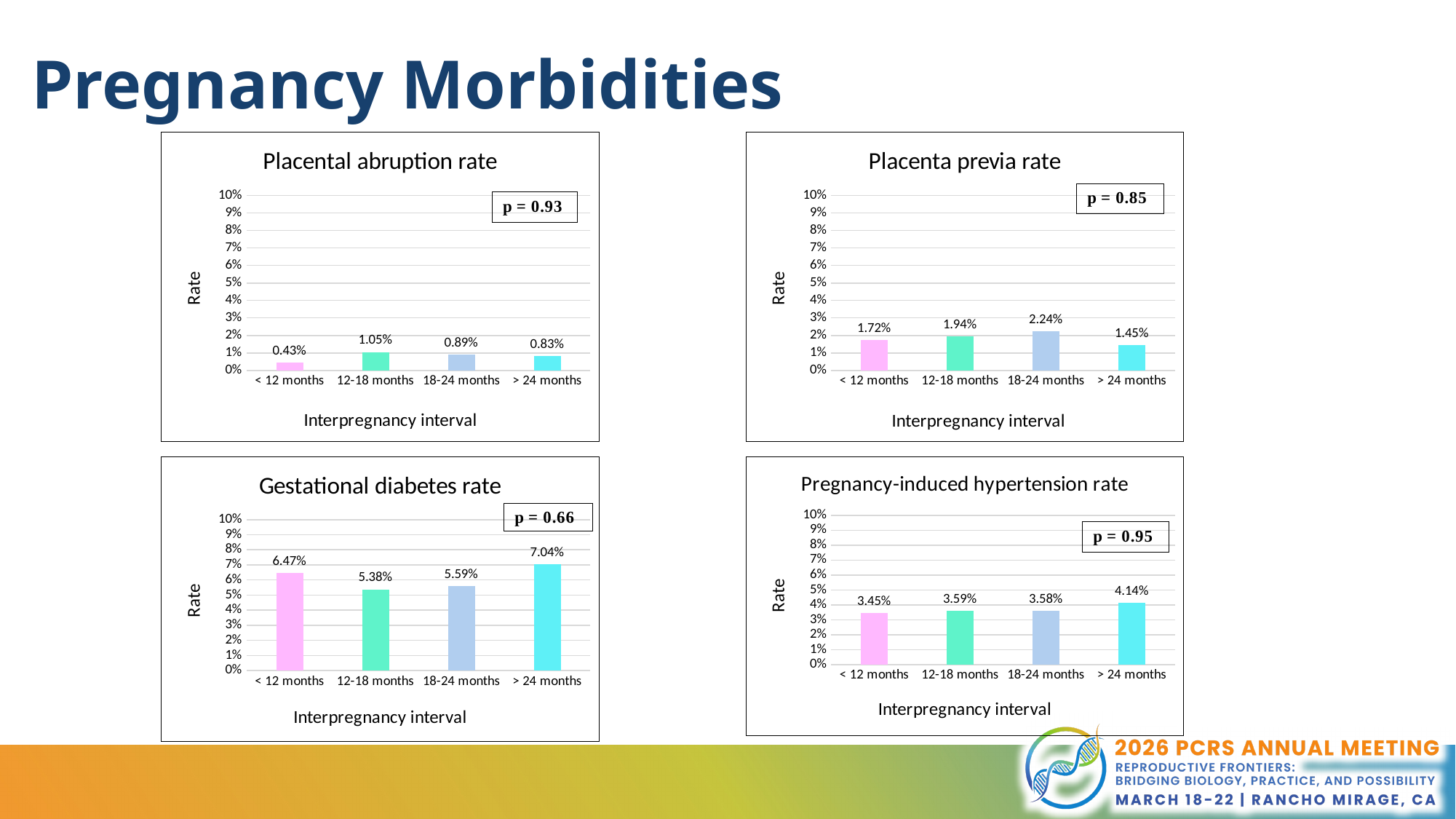
In the Placental abruption rate chart, which interpregnancy interval has the lowest rate? < 12 months In the Pregnancy-induced hypertension rate chart, what is the value for < 12 months? 3.45% In the Gestational diabetes rate chart, which is larger, the value for < 12 months or the value for 12-18 months? < 12 months In the Placenta previa rate chart, which interpregnancy interval has the highest rate? 18-24 months How many interpregnancy interval categories are shown in the Placental abruption rate chart? 4 In the Pregnancy-induced hypertension rate chart, which interpregnancy interval has the highest rate? > 24 months In the Placenta previa rate chart, what is the difference between the 18-24 months and > 24 months values? 0.79% In the Placental abruption rate chart, what is the value for 12-18 months? 1.05% In the Placenta previa rate chart, what is the value for 18-24 months? 2.24% What type of chart is the Gestational diabetes rate chart? Bar chart In the Gestational diabetes rate chart, what is the difference between the > 24 months and 12-18 months values? 1.66% In the Gestational diabetes rate chart, what is the value for > 24 months? 7.04%